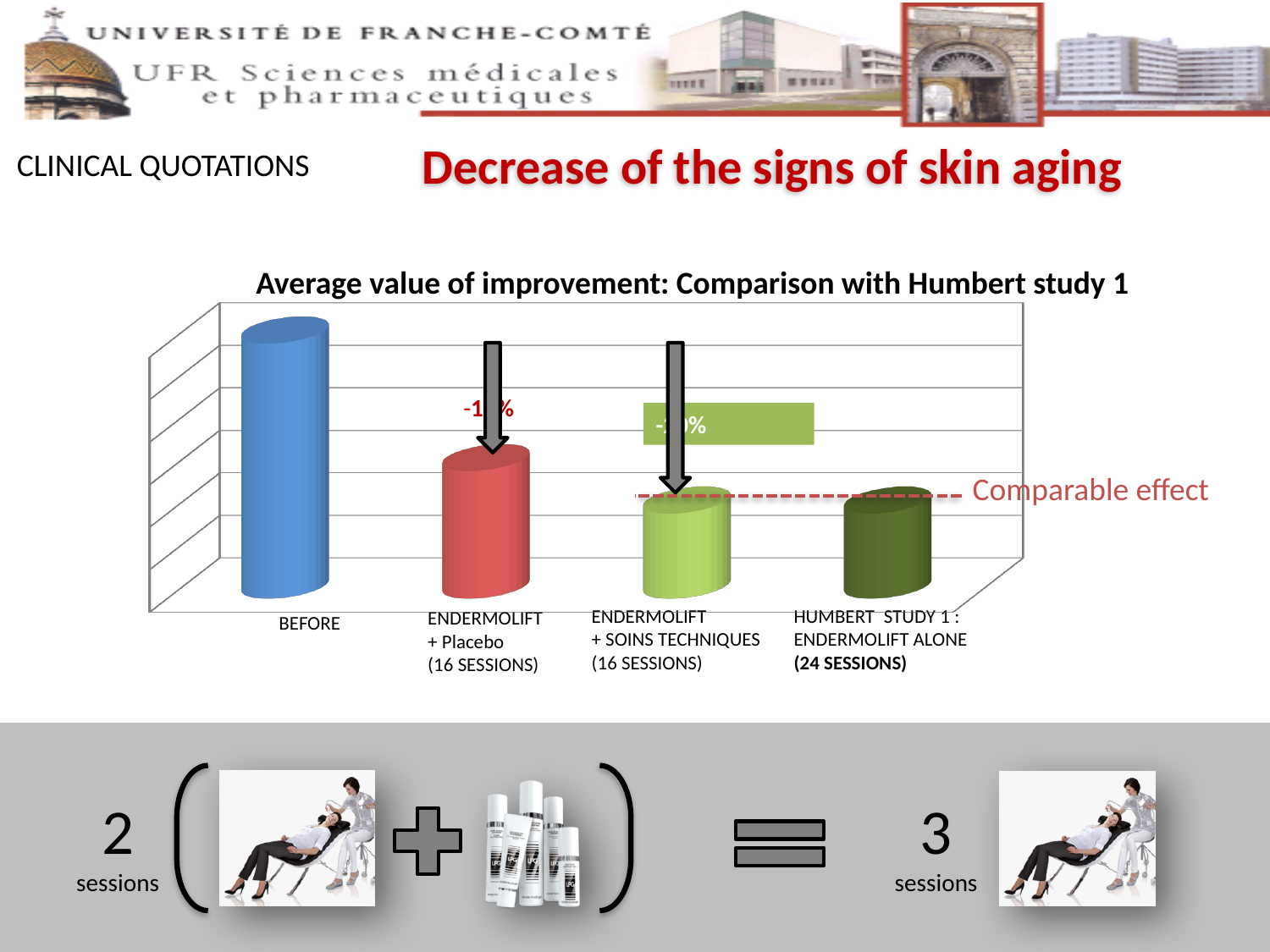
How many sessions are stated for the HUMBERT STUDY 1: ENDERMOLIFT ALONE category? 24 SESSIONS What is the title of the chart? Average value of improvement: Comparison with Humbert study 1 Which is larger, the bar for BEFORE or the bar for ENDERMOLIFT + Placebo (16 SESSIONS)? BEFORE Which is larger, the bar for ENDERMOLIFT + Placebo (16 SESSIONS) or the bar for ENDERMOLIFT + SOINS TECHNIQUES (16 SESSIONS)? ENDERMOLIFT + Placebo (16 SESSIONS) Which category has the highest bar in the chart? BEFORE How many categories are plotted in the chart? 4 What kind of chart is shown on the slide? bar chart Do the bar values rise or fall from BEFORE to ENDERMOLIFT + SOINS TECHNIQUES (16 SESSIONS)? fall What colour is the bar for BEFORE? blue